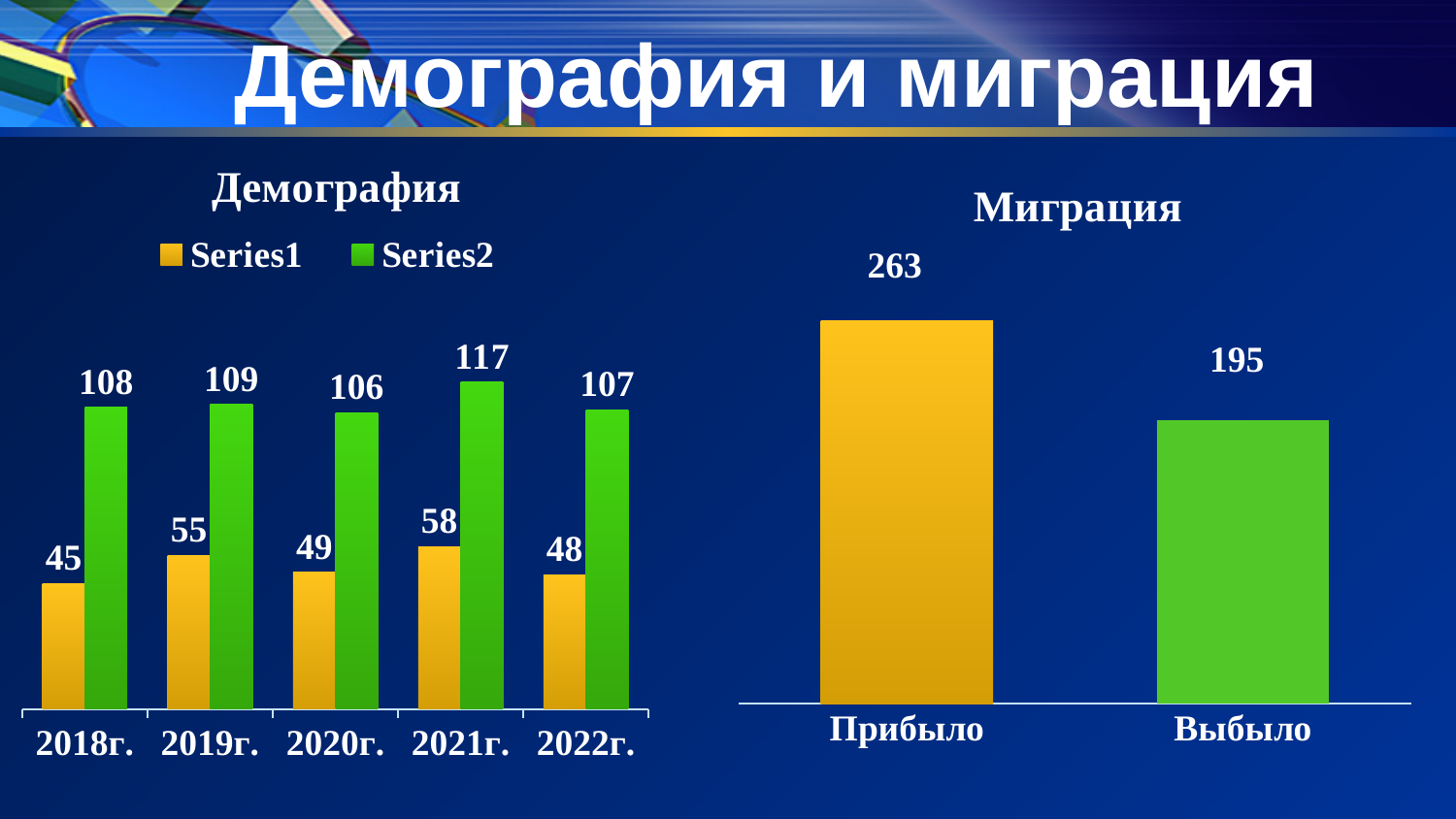
In the Миграция chart, what is the difference between Прибыло and Выбыло? 68 In the Демография chart, which year has the highest Series2 value? 2021г. In the Демография chart, which year has the lowest Series1 value? 2018г. What kind of chart is the Миграция chart? Bar chart How many years are shown on the x axis of the Демография chart? 5 In the Миграция chart, what is the value for Прибыло? 263 In the Демография chart, what colour are the Series2 bars? Green In the Демография chart, what is the Series2 value for 2021г.? 117 In the Демография chart, what is the difference between Series2 and Series1 in 2020г.? 57 How many series does the legend of the Демография chart list? 2 In the Демография chart, which is larger: Series1 in 2021г. or Series1 in 2022г.? Series1 in 2021г. In the Демография chart, what is the Series1 value for 2019г.? 55